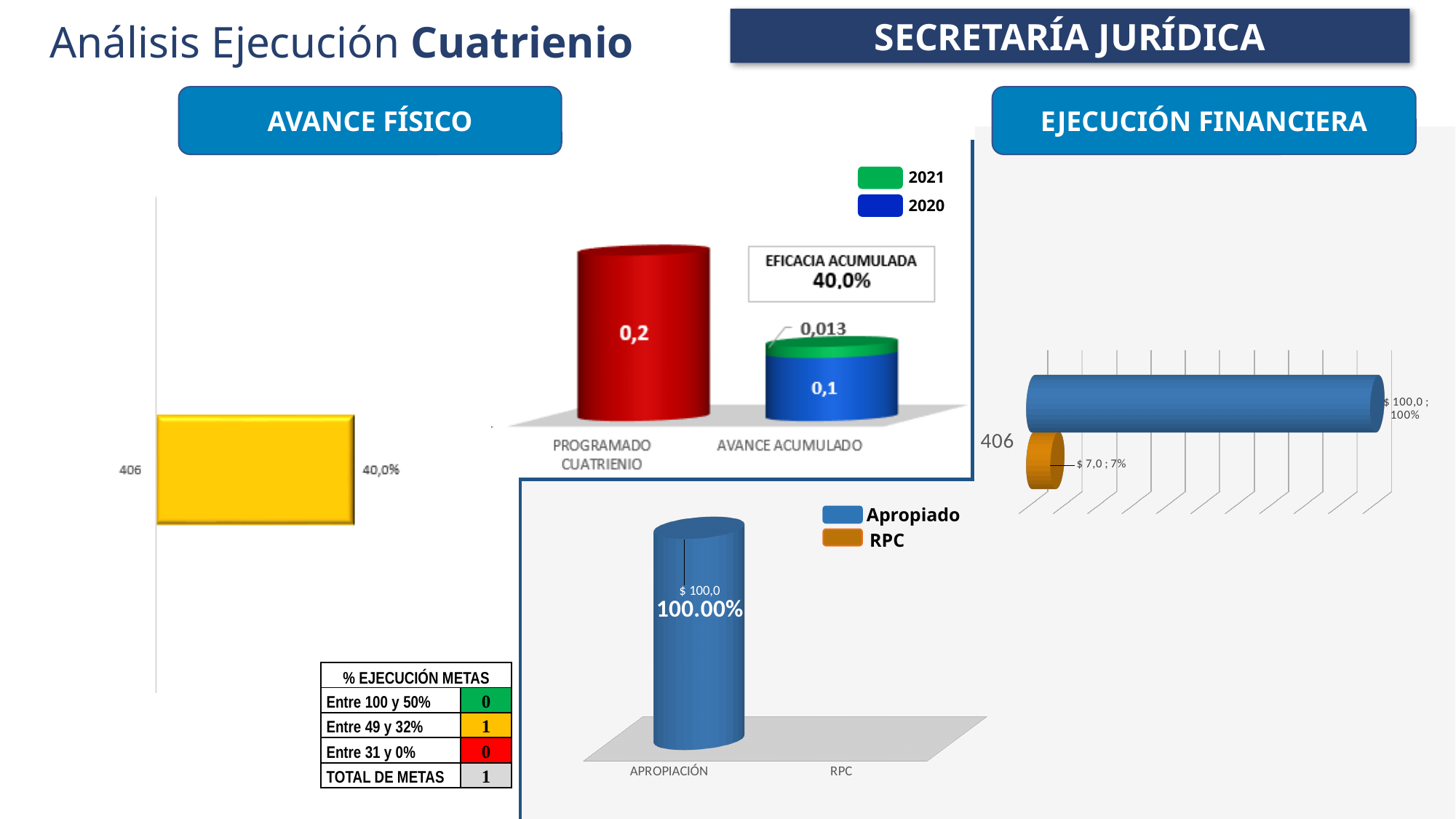
In the horizontal chart under EJECUCIÓN FINANCIERA, what value is labelled on the Apropiado bar? $ 100,0 ; 100% In the PROGRAMADO CUATRIENIO / AVANCE ACUMULADO chart, what is the 2020 value for AVANCE ACUMULADO? 0,1 In the horizontal chart under EJECUCIÓN FINANCIERA, what value is labelled on the RPC bar? $ 7,0 ; 7% In the PROGRAMADO CUATRIENIO / AVANCE ACUMULADO chart, which category has the taller bar? PROGRAMADO CUATRIENIO In the PROGRAMADO CUATRIENIO / AVANCE ACUMULADO chart, what is the 2021 value for AVANCE ACUMULADO? 0,013 In the horizontal chart under EJECUCIÓN FINANCIERA, which series has the longer bar, Apropiado or RPC? Apropiado In the yellow horizontal bar chart under AVANCE FÍSICO, what value is labelled on the bar for category 406? 40,0% In the PROGRAMADO CUATRIENIO / AVANCE ACUMULADO chart, what EFICACIA ACUMULADA percentage is shown? 40,0% In the yellow horizontal bar chart under AVANCE FÍSICO, how many bars are plotted? 1 In the bottom chart with categories APROPIACIÓN and RPC, what percentage is labelled on the APROPIACIÓN bar? 100.00% In the PROGRAMADO CUATRIENIO / AVANCE ACUMULADO chart, what is the value of the red PROGRAMADO CUATRIENIO bar? 0,2 In the PROGRAMADO CUATRIENIO / AVANCE ACUMULADO chart, how many years does the legend list? 2